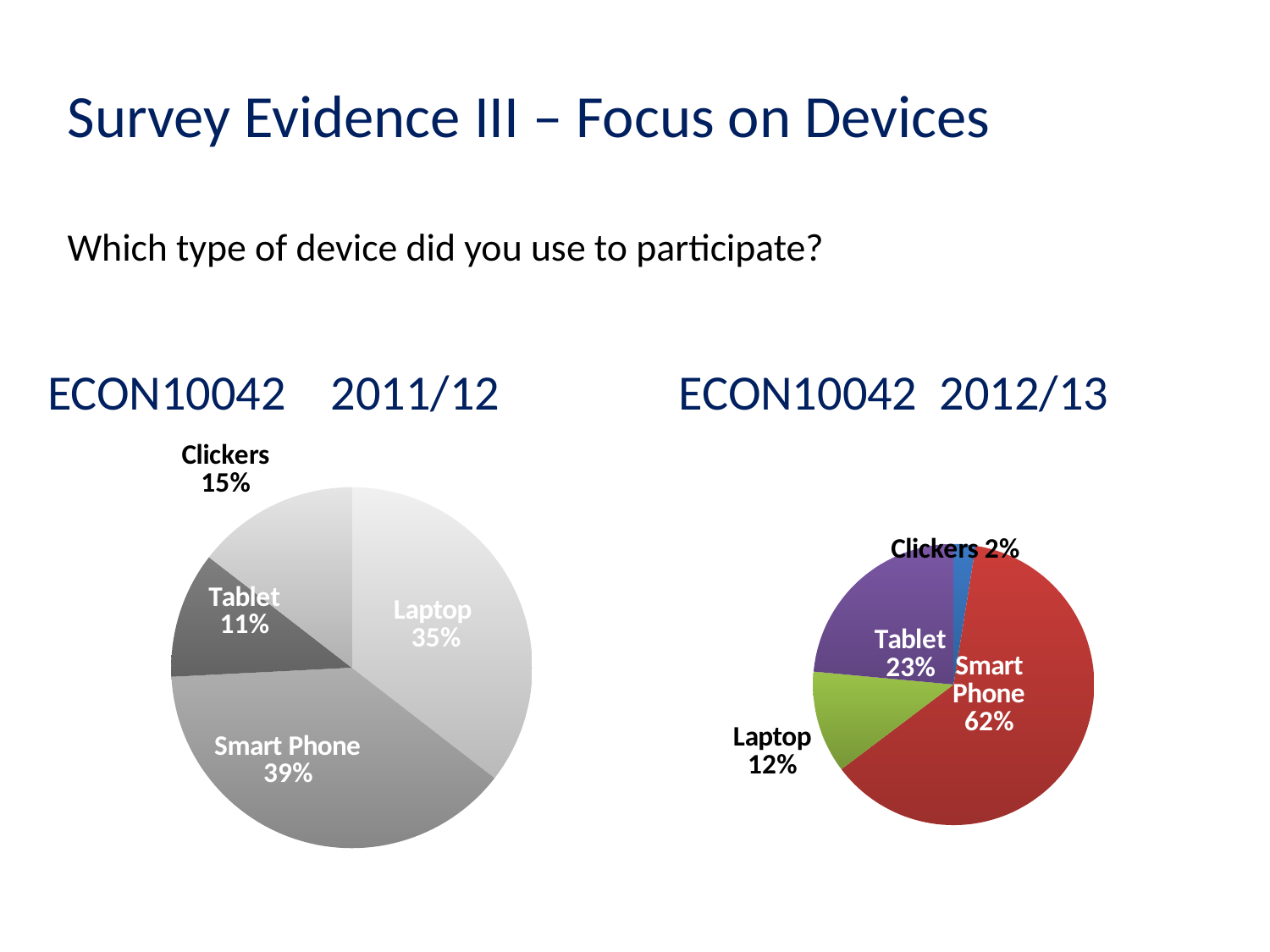
In the ECON10042 2012/13 chart, what share of respondents used a Tablet? 23% In the ECON10042 2011/12 chart, which device has the smallest share? Tablet In the ECON10042 2012/13 chart, what is the difference between the Smart Phone share and the Tablet share? 39% In the ECON10042 2012/13 chart, which device has the smallest share? Clickers In the ECON10042 2011/12 chart, which is larger: the Clickers share or the Tablet share? Clickers In the ECON10042 2012/13 chart, which device has the largest share? Smart Phone In the ECON10042 2011/12 chart, what is the difference between the Smart Phone share and the Laptop share? 4% In the ECON10042 2011/12 chart, what share of respondents used a Laptop? 35% What type of chart is used for ECON10042 2011/12? Pie chart How many device categories are shown in the ECON10042 2012/13 chart? 4 In the ECON10042 2012/13 chart, what share of respondents used Clickers? 2% In the ECON10042 2011/12 chart, what share of respondents used a Smart Phone? 39%